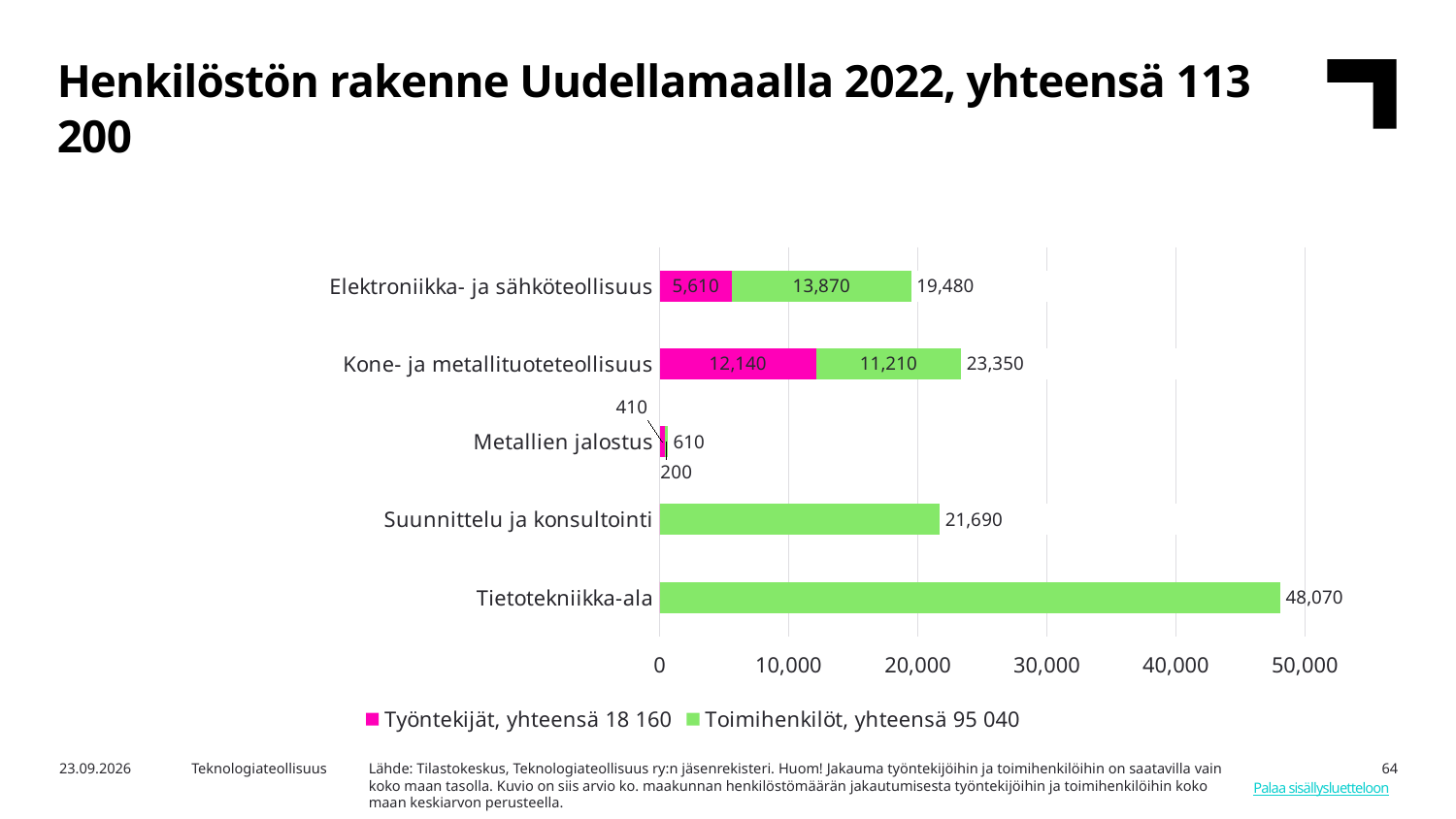
What is the Työntekijät value for Kone- ja metallituoteteollisuus? 12,140 Which category has the highest total value? Tietotekniikka-ala What is the Toimihenkilöt value for Elektroniikka- ja sähköteollisuus? 13,870 What type of chart is shown on the slide? Stacked bar chart How many series does the legend list? 2 What total is given for Toimihenkilöt in the legend? 95 040 What is the total value shown for Tietotekniikka-ala? 48,070 What is the difference between the Toimihenkilöt values for Tietotekniikka-ala and Suunnittelu ja konsultointi? 26,380 Which is larger: the Työntekijät value for Elektroniikka- ja sähköteollisuus or for Kone- ja metallituoteteollisuus? Kone- ja metallituoteteollisuus Which category has the lowest total value? Metallien jalostus How many categories are shown on the chart? 5 What is the total of the stacked bar for Kone- ja metallituoteteollisuus? 23,350